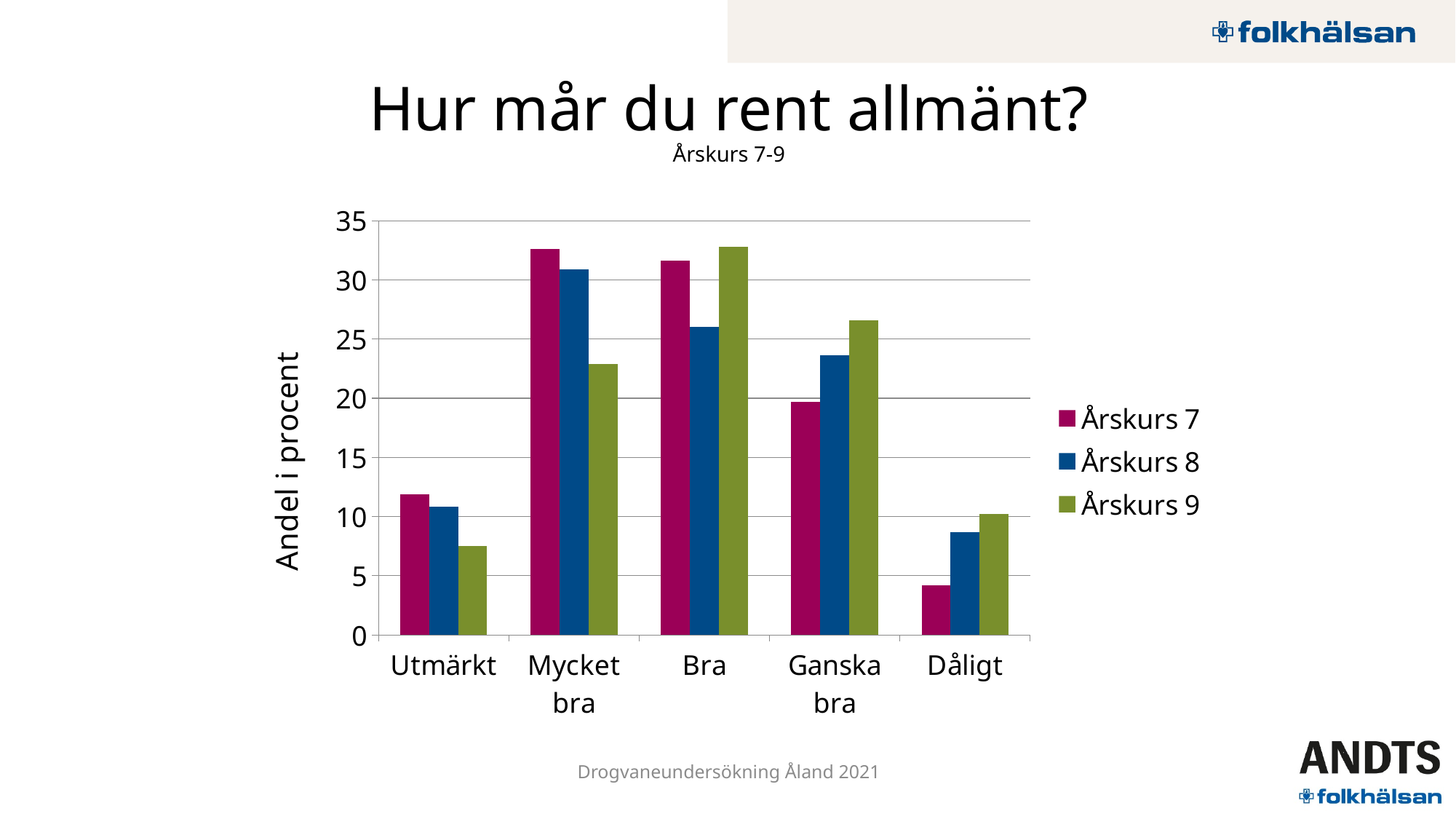
For Årskurs 7, which category has the lowest value? Dåligt For Årskurs 8, which category has the highest value? Mycket bra Is the value for Årskurs 7 in the Dåligt category greater or less than 5? less Is the value for Årskurs 9 in the Utmärkt category greater or less than 10? less In the Dåligt category, which is larger: Årskurs 8 or Årskurs 9? Årskurs 9 For Årskurs 9, which category has the highest value? Bra In the Mycket bra category, which is larger: Årskurs 7 or Årskurs 9? Årskurs 7 What is the title of the y axis? Andel i procent How many series does the legend list? 3 Is the value for Årskurs 8 in the Ganska bra category greater or less than 20? greater What kind of chart is shown on the slide? Bar chart How many categories are shown on the x axis? 5